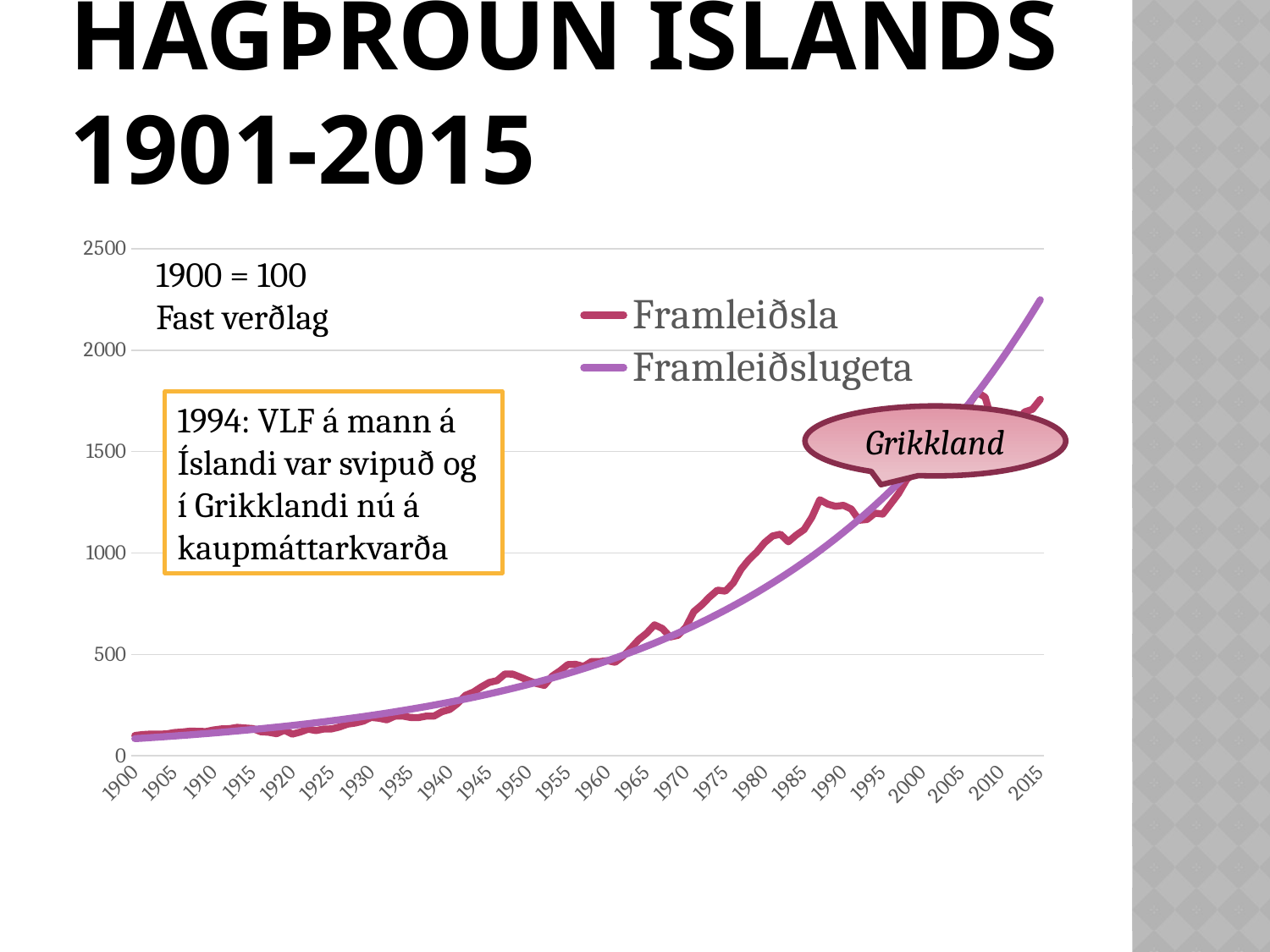
How many year labels are shown along the x axis of the chart? 24 What kind of chart is shown on the slide? line chart Is the value of Framleiðsla in 2015 greater or less than 2000? less Does the Framleiðslugeta line rise or fall from 1900 to 2015? rise Is the value of Framleiðslugeta in 2000 greater or less than 1000? greater What is the highest value shown on the vertical axis of the chart? 2500 Is the value of Framleiðslugeta in 1970 greater or less than 1000? less In 2015, which series has the higher value, Framleiðsla or Framleiðslugeta? Framleiðslugeta What are the two series named in the chart legend? Framleiðsla and Framleiðslugeta How many series does the chart legend list? 2